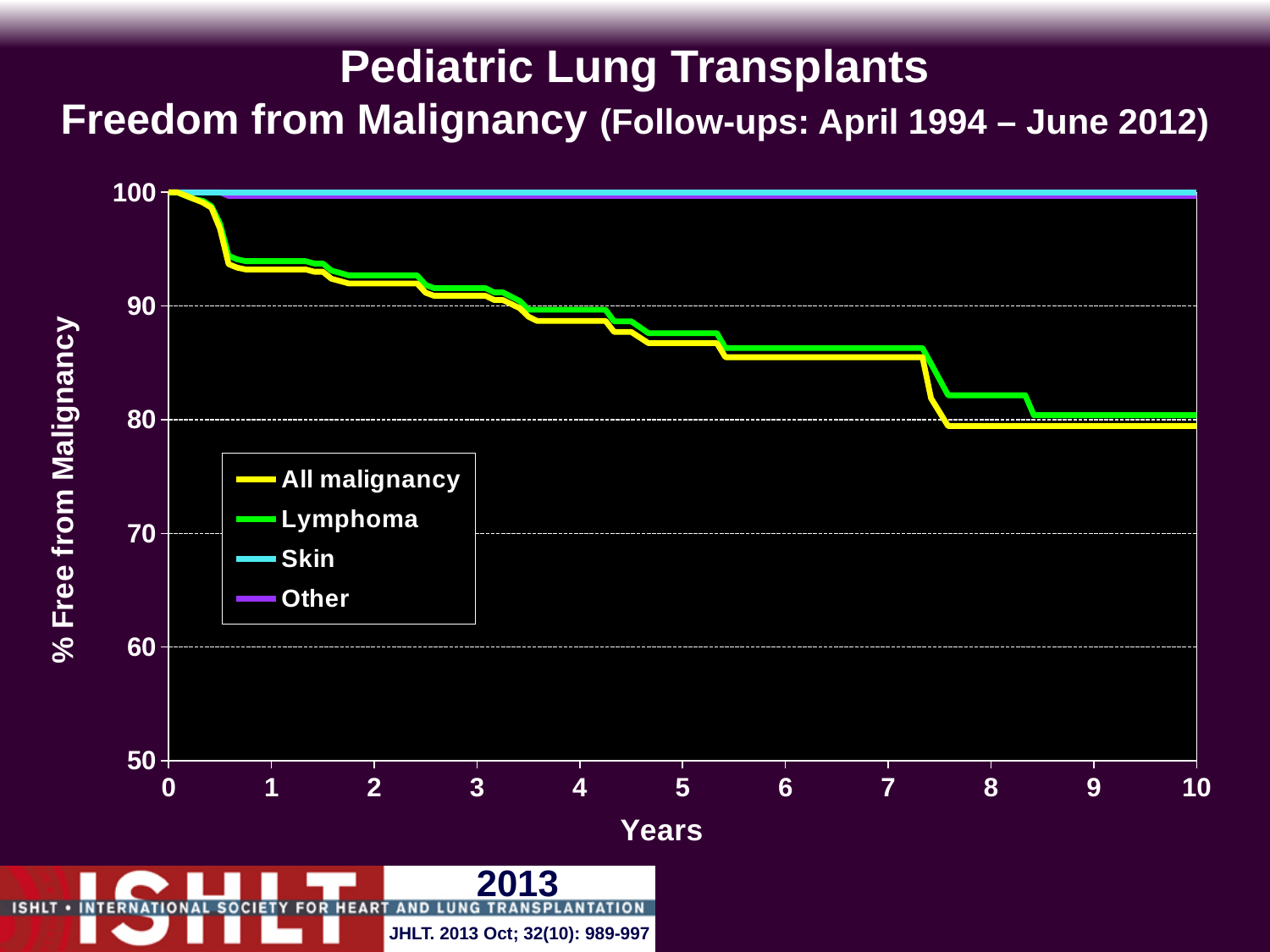
Is the value for Skin at 10 years greater or less than 90? greater What colour is the line for All malignancy? Yellow Is the value for Lymphoma at 10 years greater or less than 90? less Which series has the lowest value at 10 years? All malignancy Does the All malignancy line rise or fall as years increase? Fall At 10 years, which is higher: Skin or All malignancy? Skin Is the value for All malignancy at 5 years greater or less than 90? less What kind of chart is shown on the slide? Line chart How many series does the legend list? 4 At 8 years, which is higher: Lymphoma or All malignancy? Lymphoma Which series are listed in the legend? All malignancy, Lymphoma, Skin, Other